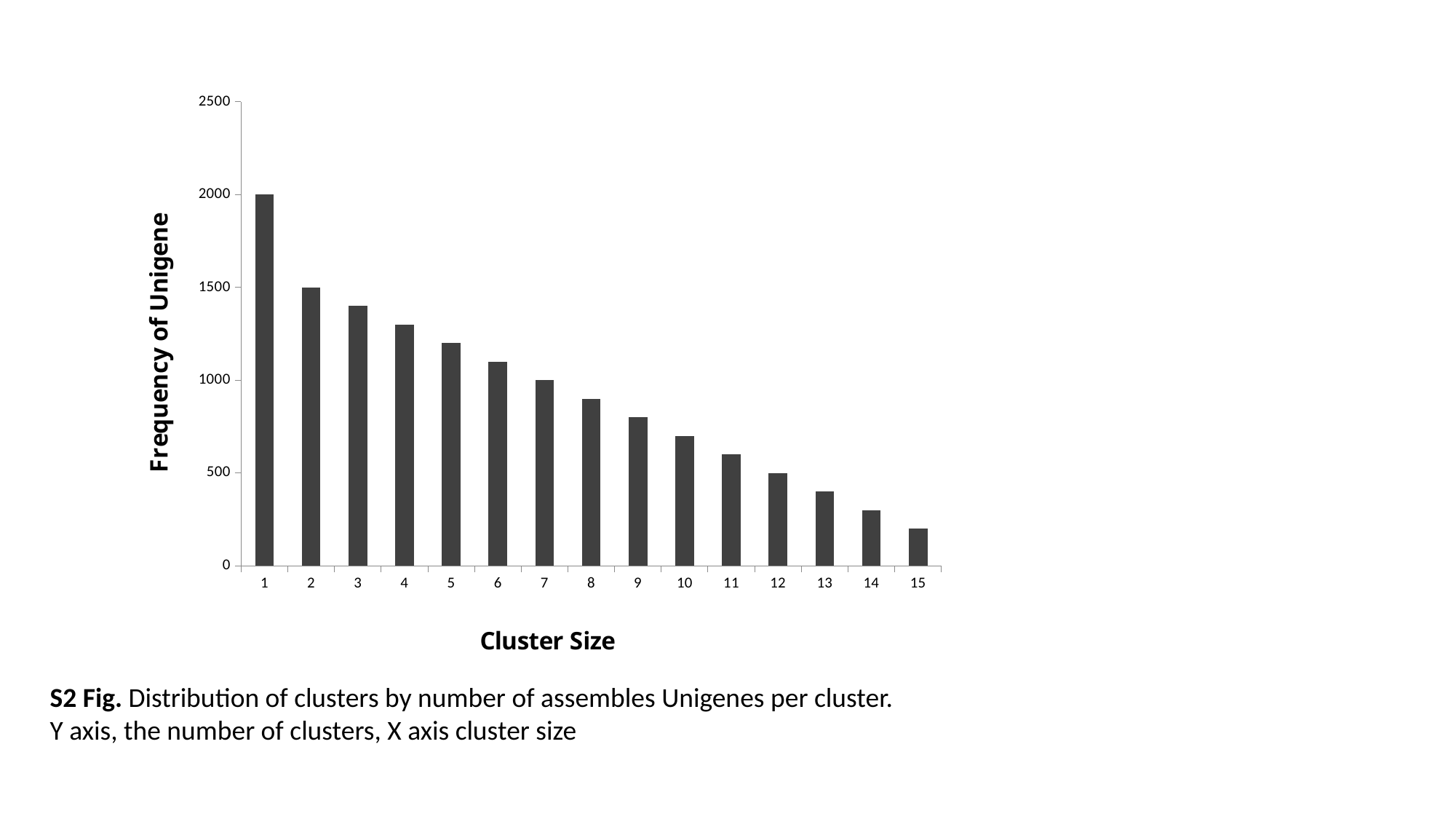
Which cluster size has the lowest frequency of Unigene? 15 What is the difference between the frequency of Unigene for cluster size 1 and cluster size 7? 1000 How many cluster sizes are plotted along the x axis? 15 What is the frequency of Unigene for cluster size 12? 500 What is the frequency of Unigene for cluster size 2? 1500 What is the title of the y axis? Frequency of Unigene What kind of chart is shown on the slide? bar chart What is the frequency of Unigene for cluster size 7? 1000 Which cluster size has the highest frequency of Unigene? 1 Do the values rise or fall as cluster size increases along the x axis? fall What is the frequency of Unigene for cluster size 1? 2000 Is the value for cluster size 4 greater or less than 1000? greater